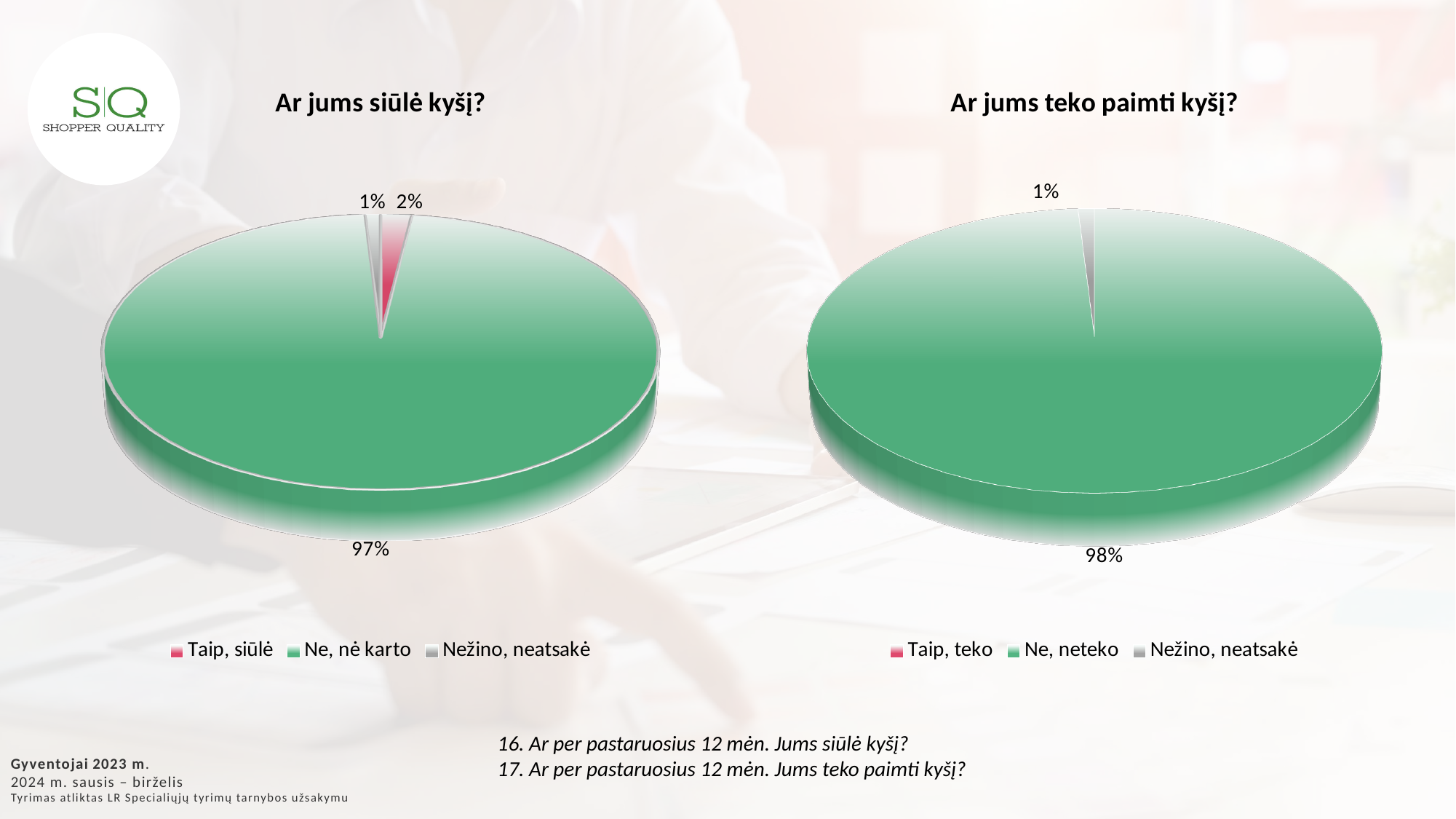
In the chart titled "Ar jums siūlė kyšį?", what colour is the "Taip, siūlė" slice? Red In the chart titled "Ar jums teko paimti kyšį?", which category has the largest slice? Ne, neteko In the chart titled "Ar jums siūlė kyšį?", which category has the largest slice? Ne, nė karto In the chart titled "Ar jums siūlė kyšį?", what percentage is shown for "Nežino, neatsakė"? 1% In the chart titled "Ar jums teko paimti kyšį?", what percentage is shown for "Ne, neteko"? 98% In the chart titled "Ar jums teko paimti kyšį?", what percentage is shown for "Nežino, neatsakė"? 1% In the chart titled "Ar jums siūlė kyšį?", what is the difference between "Ne, nė karto" and "Taip, siūlė"? 95% How many entries does the legend of the chart titled "Ar jums teko paimti kyšį?" list? 3 What type of chart is used on the left side of the slide? Pie chart In the chart titled "Ar jums siūlė kyšį?", what percentage is shown for "Ne, nė karto"? 97% In the chart titled "Ar jums siūlė kyšį?", which is larger, "Taip, siūlė" or "Nežino, neatsakė"? Taip, siūlė In the chart titled "Ar jums siūlė kyšį?", what percentage is shown for "Taip, siūlė"? 2%